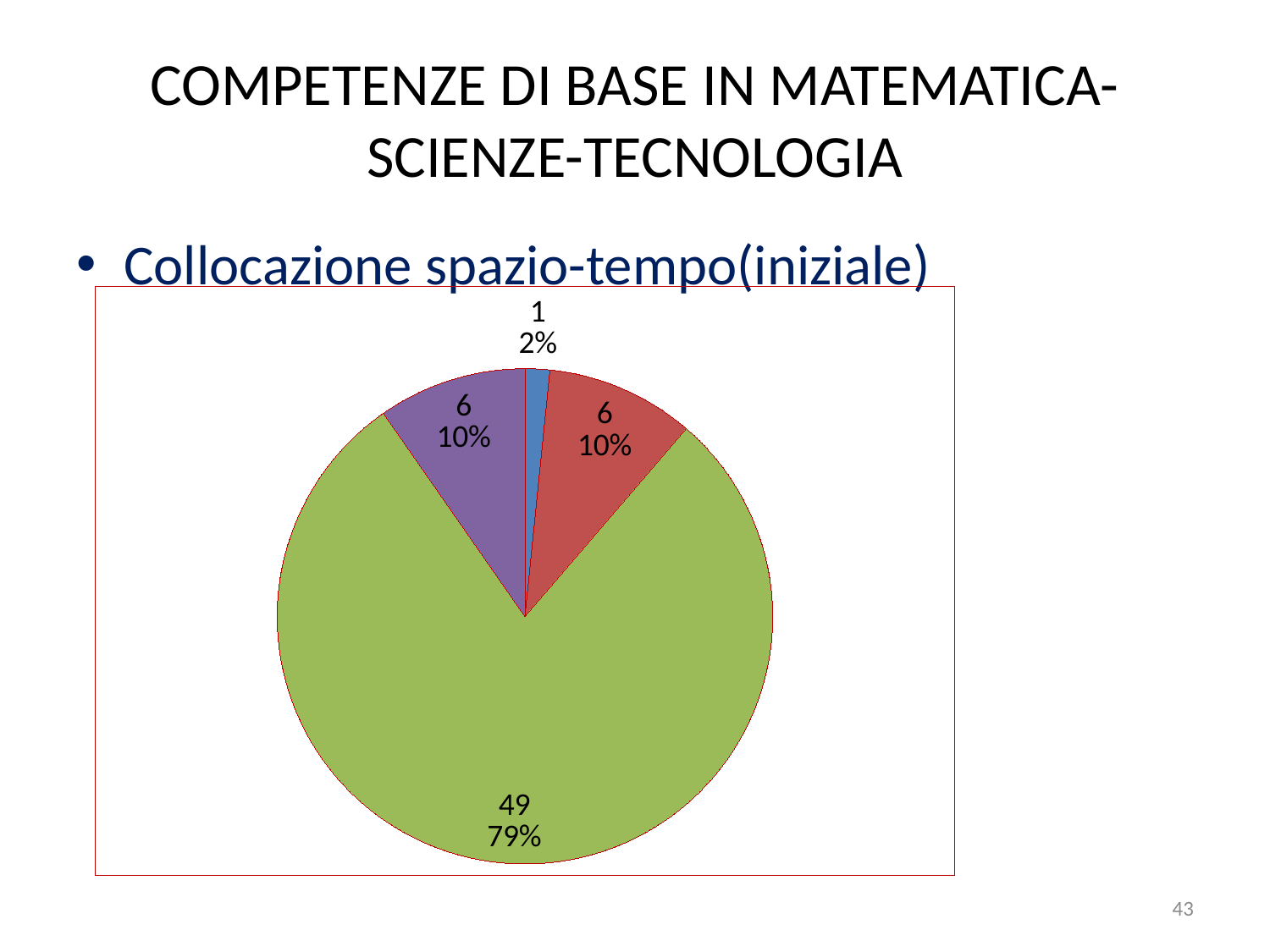
What value is shown on the blue slice of the pie chart? 1 Which slice of the pie chart is the smallest? the blue slice (1, 2%) What is the total of all the values shown on the pie chart? 62 What value is shown on the green slice of the pie chart? 49 What percentage is shown on the purple slice of the pie chart? 10% What value is shown on the red slice of the pie chart? 6 How many slices does the pie chart have? 4 What kind of chart is shown on the slide? pie chart Which slice of the pie chart is the largest? the green slice (49, 79%) What percentage is shown on the blue slice of the pie chart? 2% What is the difference between the value of the green slice and the value of the red slice? 43 What percentage is shown on the green slice of the pie chart? 79%